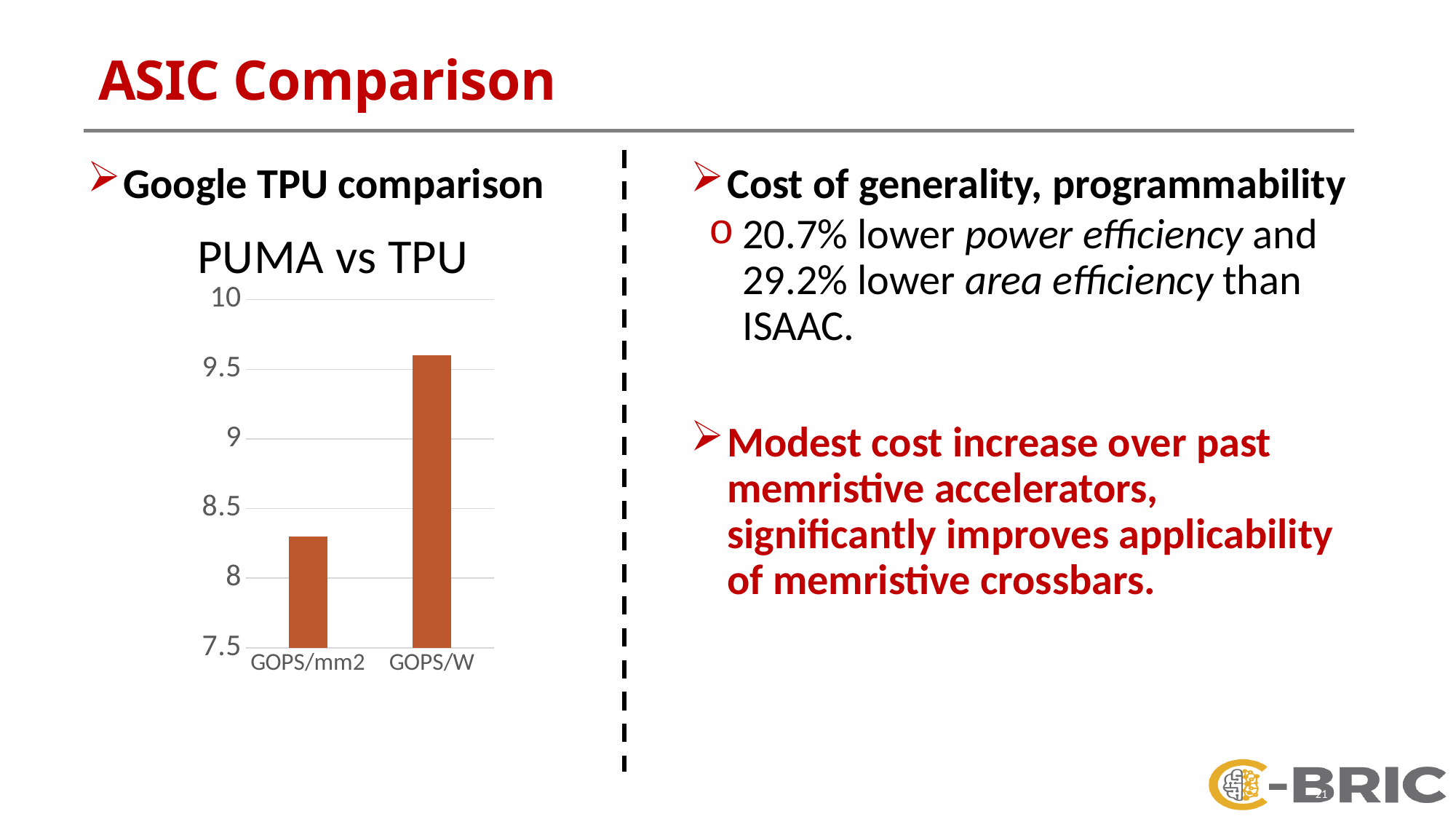
Which category has the highest bar in the chart? GOPS/W What is the title of the chart? PUMA vs TPU Is the value for GOPS/mm2 greater or less than 8? greater What kind of chart is shown on the slide? bar chart Is the value for GOPS/mm2 greater or less than 8.5? less Do the values rise or fall from GOPS/mm2 to GOPS/W? rise Which is larger, the value for GOPS/mm2 or the value for GOPS/W? GOPS/W Is the value for GOPS/W greater or less than 10? less What is the lowest value shown on the chart's vertical axis? 7.5 How many categories are plotted in the chart? 2 Which category has the lowest bar in the chart? GOPS/mm2